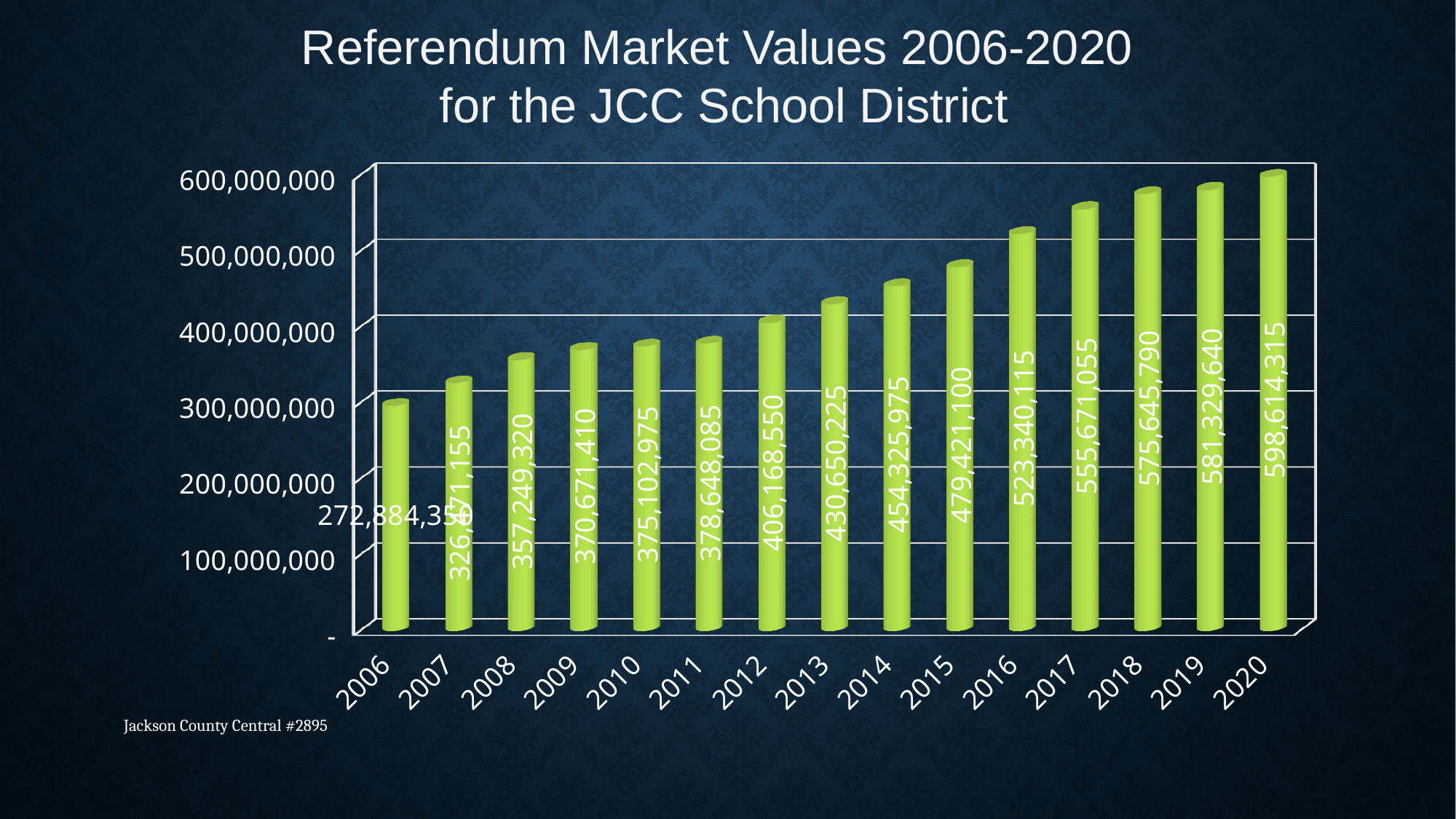
What is the referendum market value for 2012? 406,168,550 Which year has the highest referendum market value? 2020 What kind of chart is shown on the slide? Bar chart What is the difference between the 2020 and 2019 referendum market values? 17,284,675 Do the referendum market values rise or fall from 2006 to 2020? Rise What is the referendum market value for 2016? 523,340,115 Which year has the lowest referendum market value? 2006 What is the referendum market value for 2020? 598,614,315 How many years are shown on the x axis? 15 Which year has a larger referendum market value, 2013 or 2015? 2015 What is the referendum market value for 2009? 370,671,410